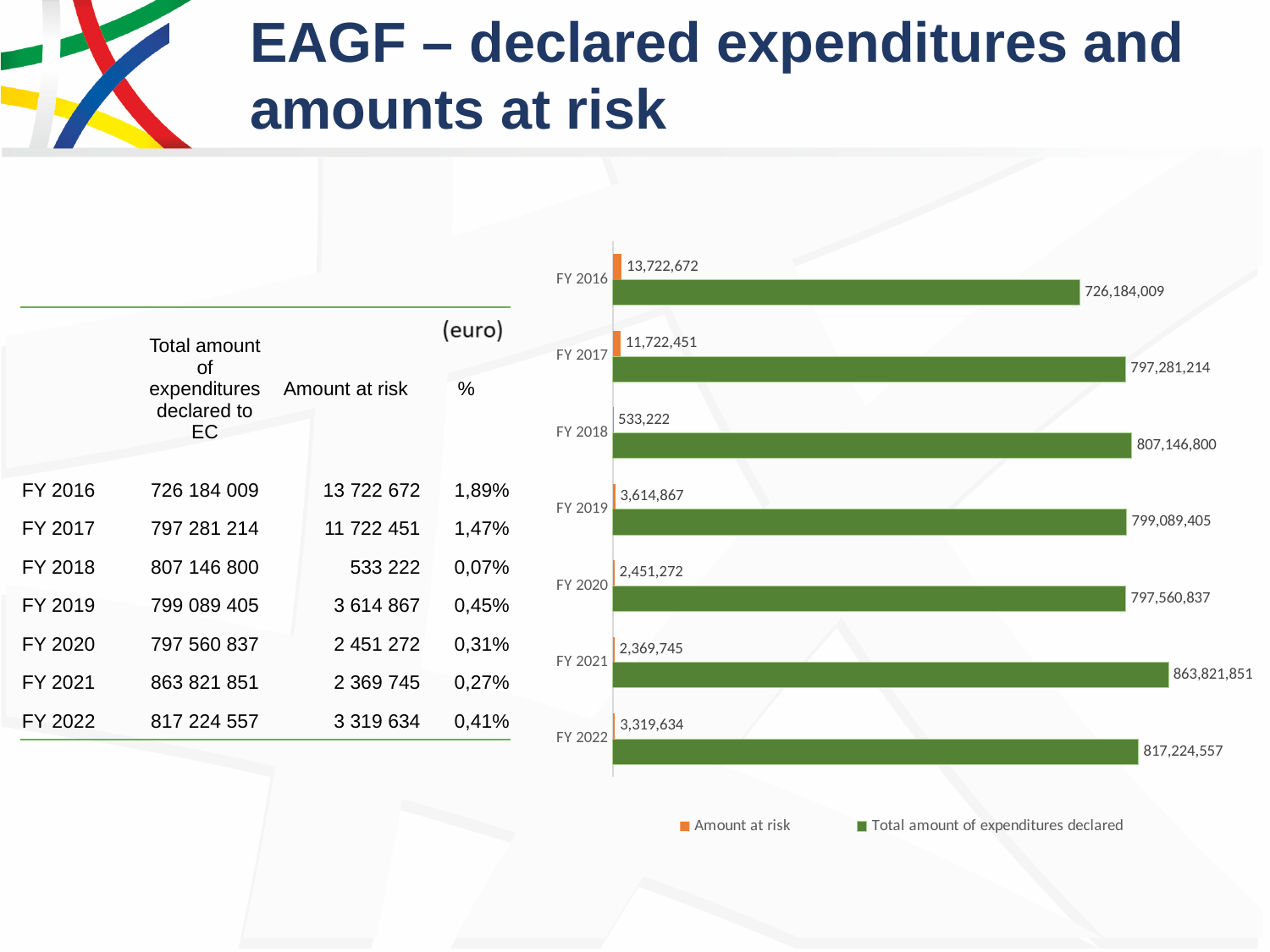
Which is larger: the total amount of expenditures declared in FY 2019 or in FY 2020? FY 2019 How many fiscal years are shown in the chart? 7 By how much does the amount at risk in FY 2016 exceed the amount at risk in FY 2017? 2,000,221 What is the difference between the total amount of expenditures declared in FY 2021 and in FY 2016? 137,637,842 Which fiscal year has the highest total amount of expenditures declared? FY 2021 What type of chart is shown on the slide? Bar chart How many series does the chart legend list? 2 What is the amount at risk for FY 2019 in the chart? 3,614,867 Which fiscal year has the highest amount at risk? FY 2016 Which fiscal year has the lowest total amount of expenditures declared? FY 2016 What is the total amount of expenditures declared for FY 2018 in the chart? 807,146,800 Which fiscal year has the lowest amount at risk? FY 2018